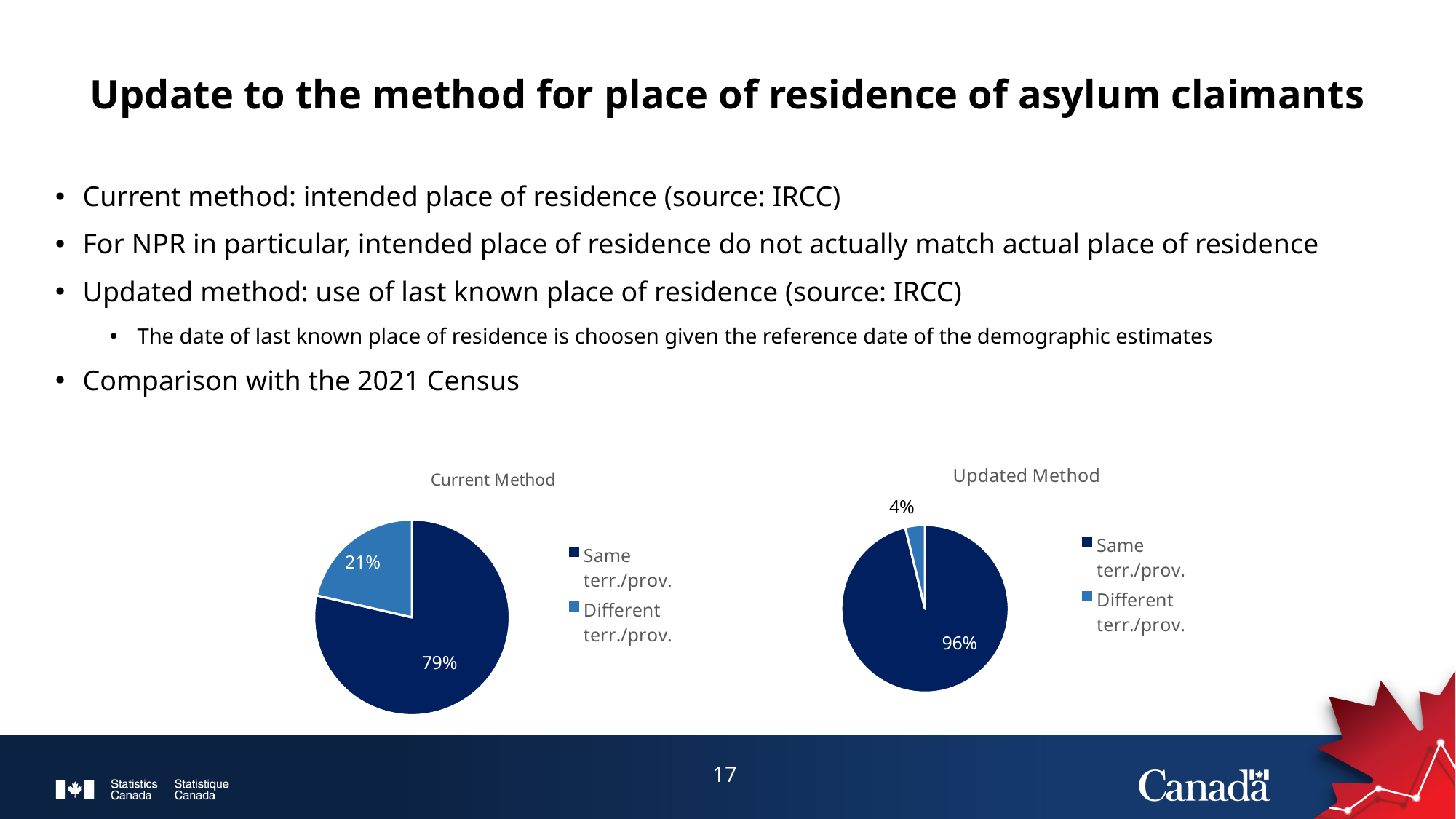
In the Current Method chart, what share is labelled for Same terr./prov.? 79% What is the title of the pie chart on the right side of the slide? Updated Method What type of chart is the Current Method chart? Pie chart In the Current Method chart, which slice is the largest? Same terr./prov. How many slices does the Updated Method pie chart have? 2 In the Updated Method chart, which slice is the smallest? Different terr./prov. Which chart shows a larger share for Different terr./prov., Current Method or Updated Method? Current Method In the Updated Method chart, what share is labelled for Different terr./prov.? 4% What is the difference between the Same terr./prov. share in the Updated Method chart and in the Current Method chart? 17 percentage points How many entries does the legend of the Current Method chart list? 2 In the Current Method chart, what share is labelled for Different terr./prov.? 21% In the Updated Method chart, what share is labelled for Same terr./prov.? 96%